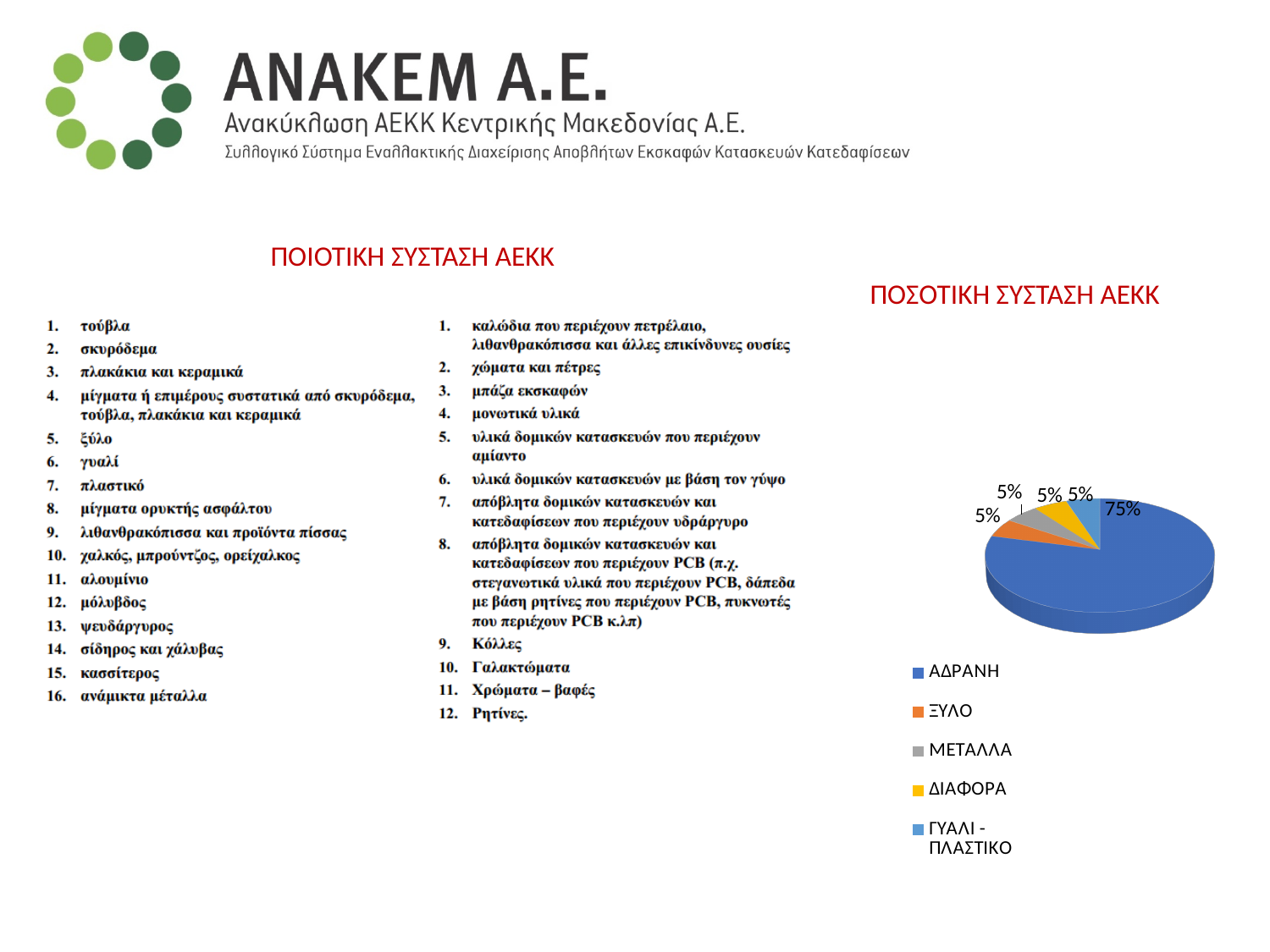
What kind of chart is shown under the heading ΠΟΣΟΤΙΚΗ ΣΥΣΤΑΣΗ ΑΕΚΚ? Pie chart What is the value shown for ΞΥΛΟ in the pie chart? 5% What is the value shown for ΓΥΑΛΙ - ΠΛΑΣΤΙΚΟ in the pie chart? 5% Which is larger in the pie chart, ΑΔΡΑΝΗ or ΔΙΑΦΟΡΑ? ΑΔΡΑΝΗ What is the title of the pie chart on the slide? ΠΟΣΟΤΙΚΗ ΣΥΣΤΑΣΗ ΑΕΚΚ What is the value shown for ΜΕΤΑΛΛΑ in the pie chart? 5% What share of the pie does ΑΔΡΑΝΗ represent? 75% How many entries does the legend of the pie chart list? 5 Which category has the largest share in the pie chart? ΑΔΡΑΝΗ What colour is the ΑΔΡΑΝΗ slice in the pie chart? Blue By how many percentage points does ΑΔΡΑΝΗ exceed ΞΥΛΟ in the pie chart? 70 percentage points How many slices does the pie chart have? 5